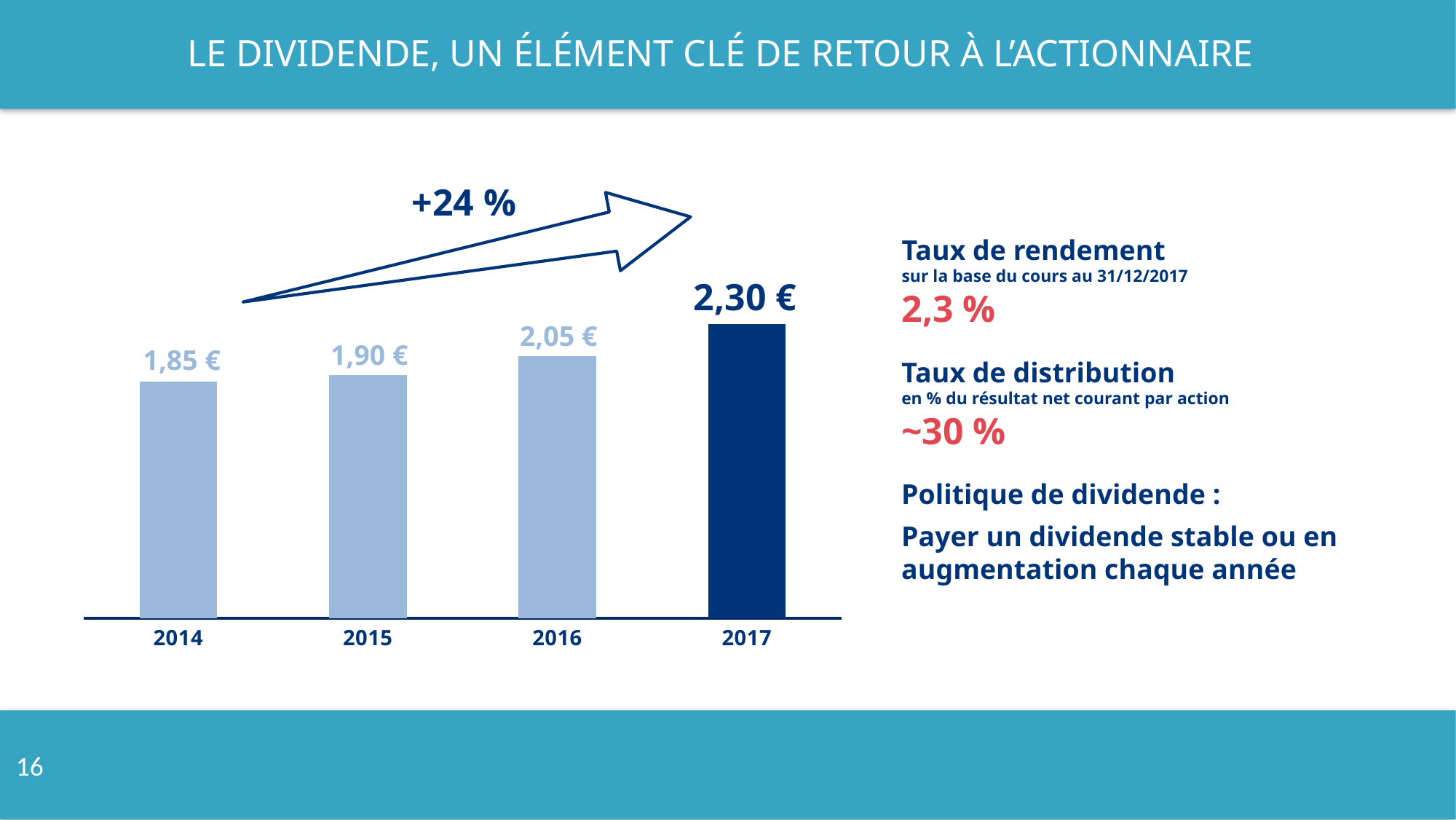
What kind of chart is shown on the slide? Bar chart Which is larger, the dividend for 2016 or for 2015? 2016 Do the dividend values rise or fall from 2014 to 2017? Rise What is the dividend value shown for 2014? 1,85 € How many years are shown on the chart? 4 What is the difference between the 2017 and 2014 dividend values? 0,45 € What is the dividend value shown for 2015? 1,90 € What is the dividend value shown for 2016? 2,05 € What is the difference between the 2016 and 2015 dividend values? 0,15 € Which year has the highest dividend value? 2017 What is the dividend value shown for 2017? 2,30 € Which year has the lowest dividend value? 2014